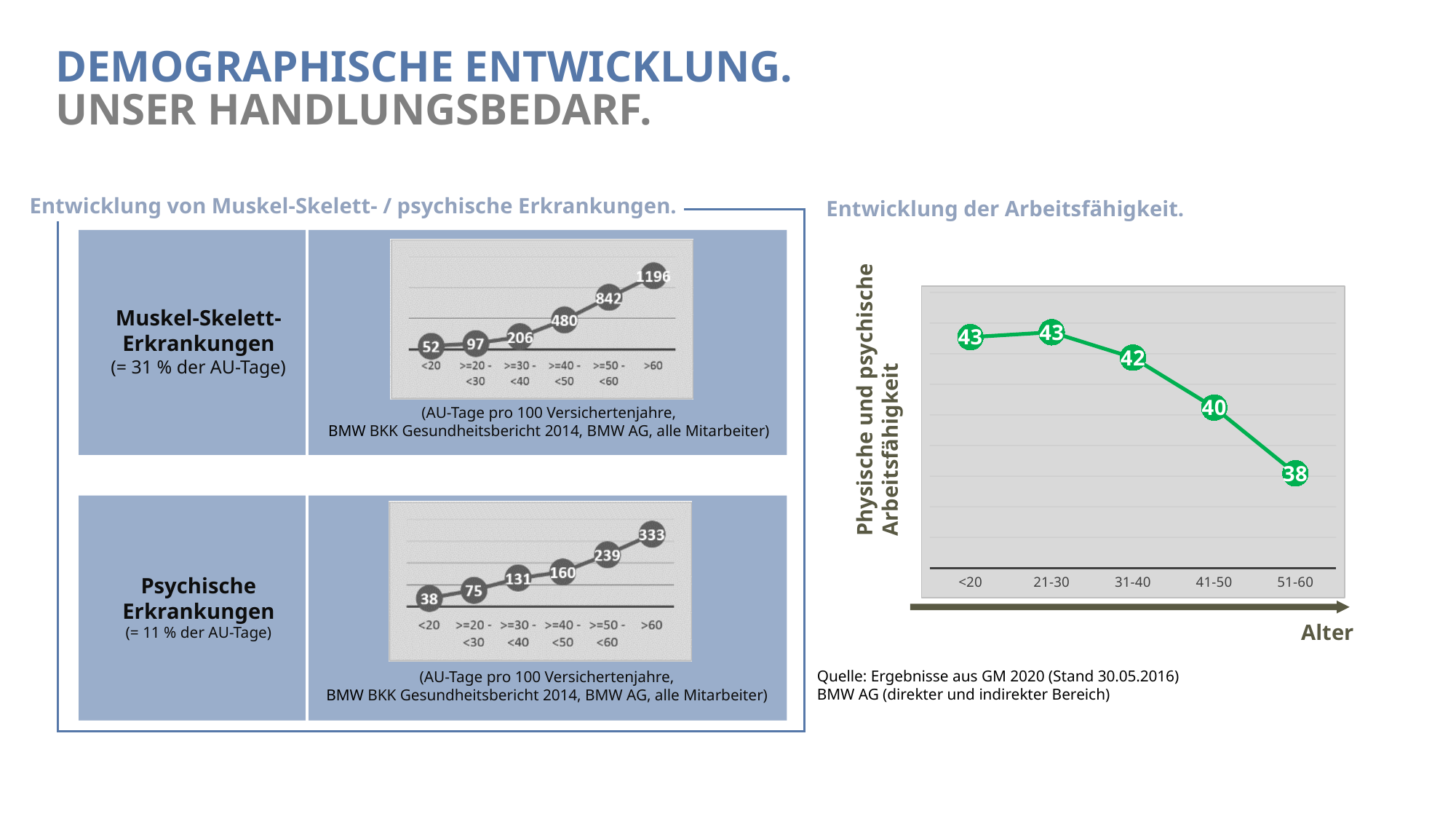
In the 'Entwicklung der Arbeitsfähigkeit' chart, which age group has the lowest value? 51-60 What kind of chart is the 'Entwicklung der Arbeitsfähigkeit' chart? line chart In the Muskel-Skelett-Erkrankungen chart, what is the value for the >60 age group? 1196 In the Psychische Erkrankungen chart, what is the difference between the values for >60 and >=50 - <60? 94 In the Psychische Erkrankungen chart, what is the value for the >=40 - <50 age group? 160 In the Psychische Erkrankungen chart, which age group has the highest value? >60 In the 'Entwicklung der Arbeitsfähigkeit' chart, do the values rise or fall from the youngest to the oldest age group? fall In the 'Entwicklung der Arbeitsfähigkeit' chart, what is the value for the 31-40 age group? 42 In the Muskel-Skelett-Erkrankungen chart, what is the value for the <20 age group? 52 In the 'Entwicklung der Arbeitsfähigkeit' chart, what is the difference between the values for <20 and 51-60? 5 In the 'Entwicklung der Arbeitsfähigkeit' chart, what is the value for the 51-60 age group? 38 In the 'Entwicklung der Arbeitsfähigkeit' chart, how many age groups are plotted? 5